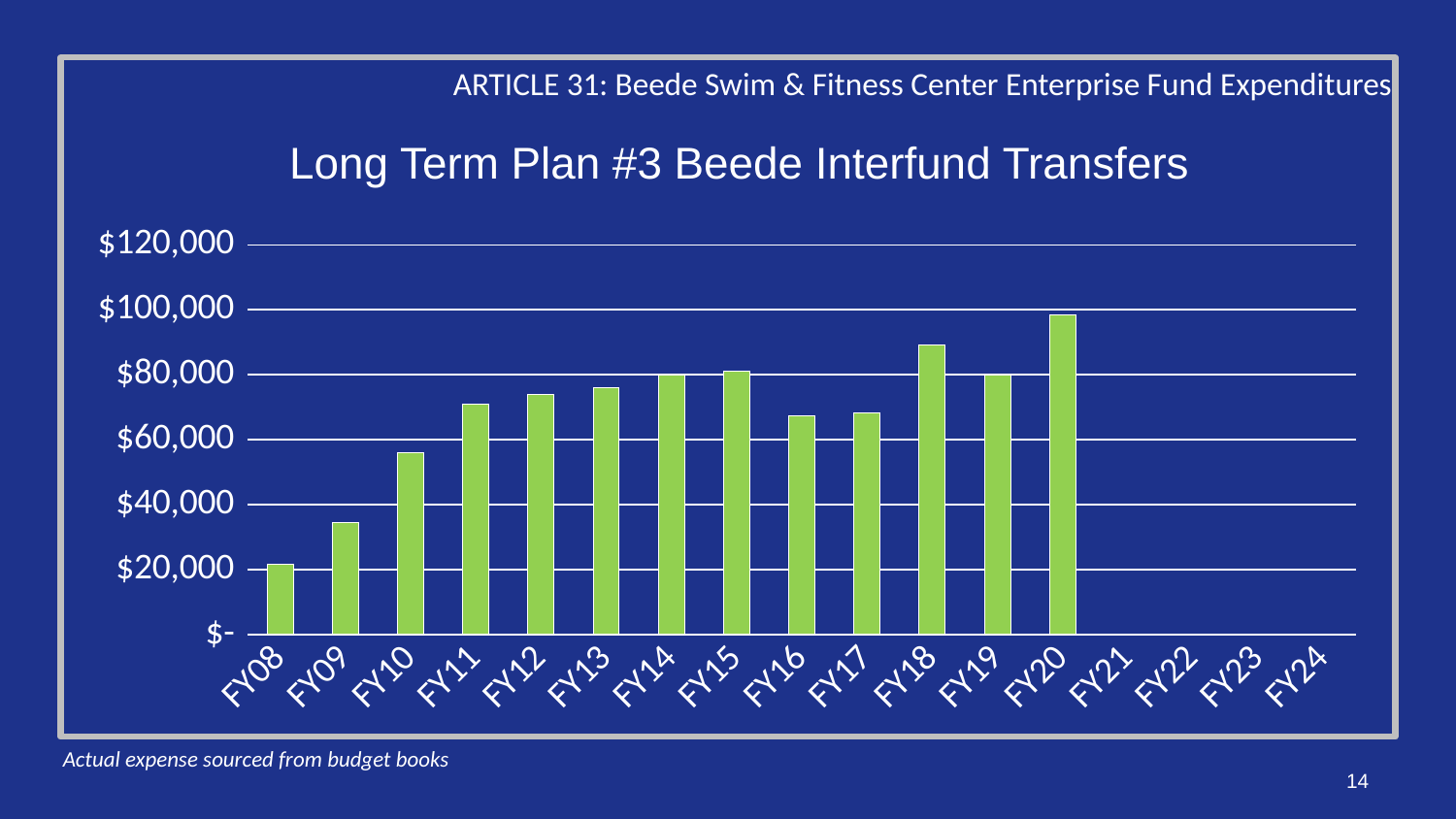
Which is larger, the value for FY18 or the value for FY19? FY18 Is the value for FY10 greater or less than $60,000? less Do the values generally rise or fall from FY08 to FY14? rise What is the title of the chart? Long Term Plan #3 Beede Interfund Transfers Which fiscal year has the lowest plotted bar? FY08 What kind of chart is shown on the slide? bar chart Is the value for FY18 greater or less than $80,000? greater How many fiscal years have a bar plotted on the chart? 13 Is the value for FY09 greater or less than $40,000? less Which is larger, the value for FY10 or the value for FY16? FY16 Which fiscal year has the highest bar? FY20